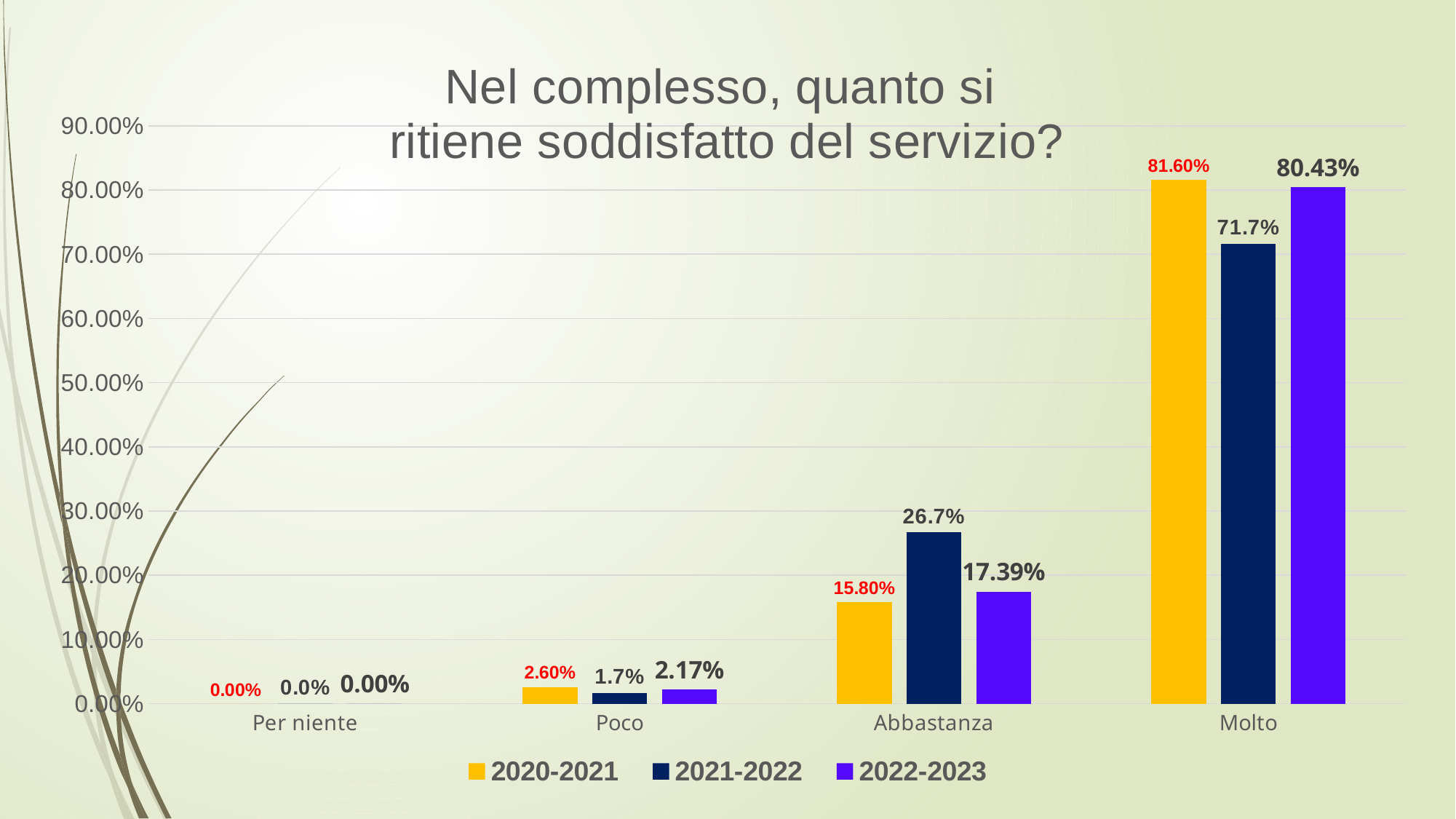
Which category has the highest value in the 2021-2022 series? Molto Is the value for Molto in the 2021-2022 series greater or less than 70.00%? greater What is the difference between the 2021-2022 and 2022-2023 values for Abbastanza? 9.31% How many series does the legend list? 3 What is the value for Poco in the 2022-2023 series? 2.17% How many categories are shown on the x axis? 4 What is the value for Molto in the 2022-2023 series? 80.43% Which category has the lowest value in the 2020-2021 series? Per niente What is the value for Abbastanza in the 2021-2022 series? 26.7% Which is larger for Molto: the 2020-2021 value or the 2021-2022 value? 2020-2021 What is the value for Molto in the 2020-2021 series? 81.60% What kind of chart is shown on the slide? Bar chart